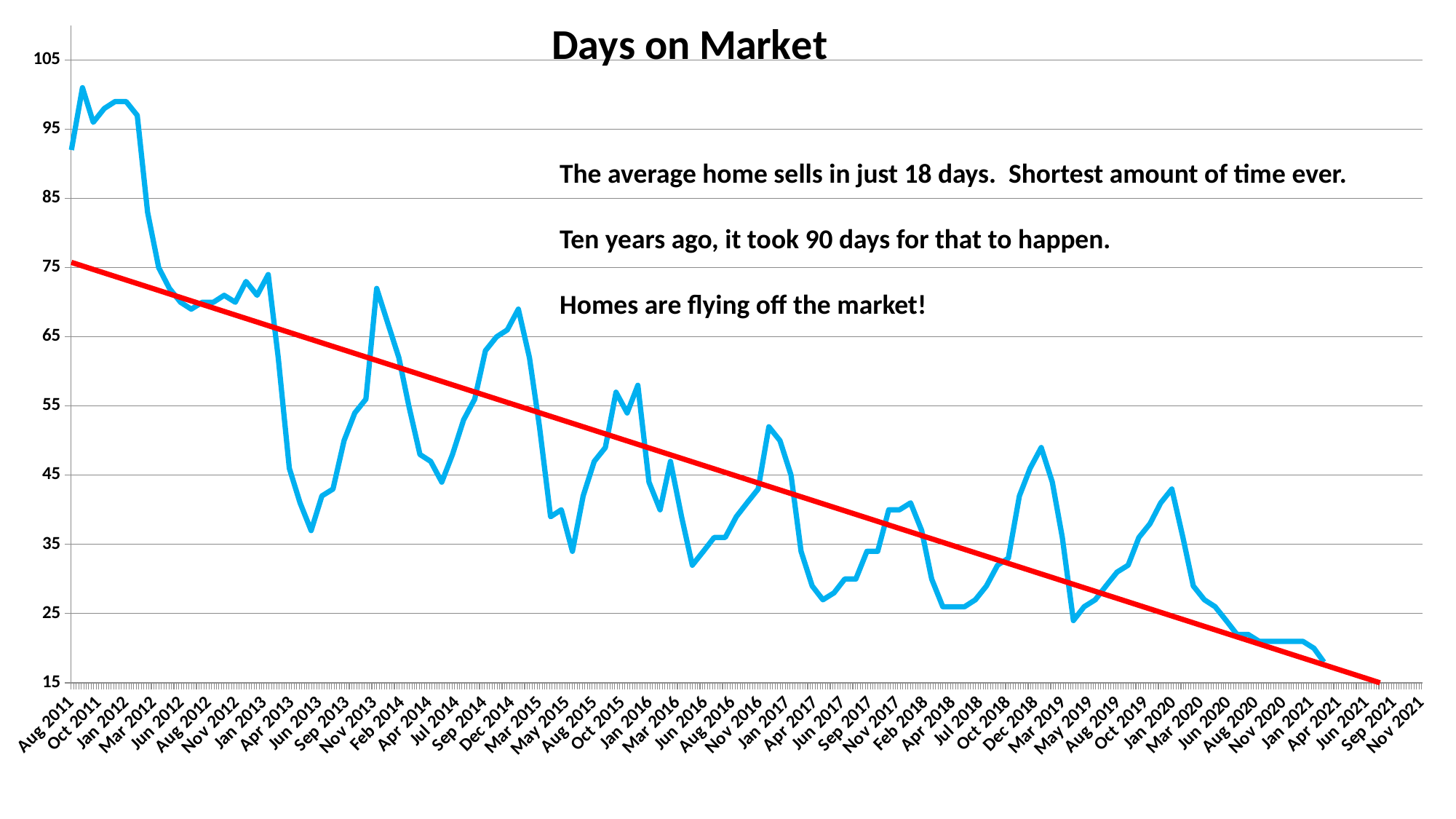
Is the value for Aug 2011 greater or less than 85? greater In which year does the blue line reach its lowest value? 2021 Does the red straight line on the chart slope upward or downward over time? downward Overall, do the values on the chart rise or fall from Aug 2011 to 2021? fall What is the title of the chart? Days on Market What kind of chart is shown on the slide? line chart Is the value for Nov 2013 greater or less than 65? less Is the value for Jun 2013 greater or less than 45? less In which year does the blue line reach its highest value? 2011